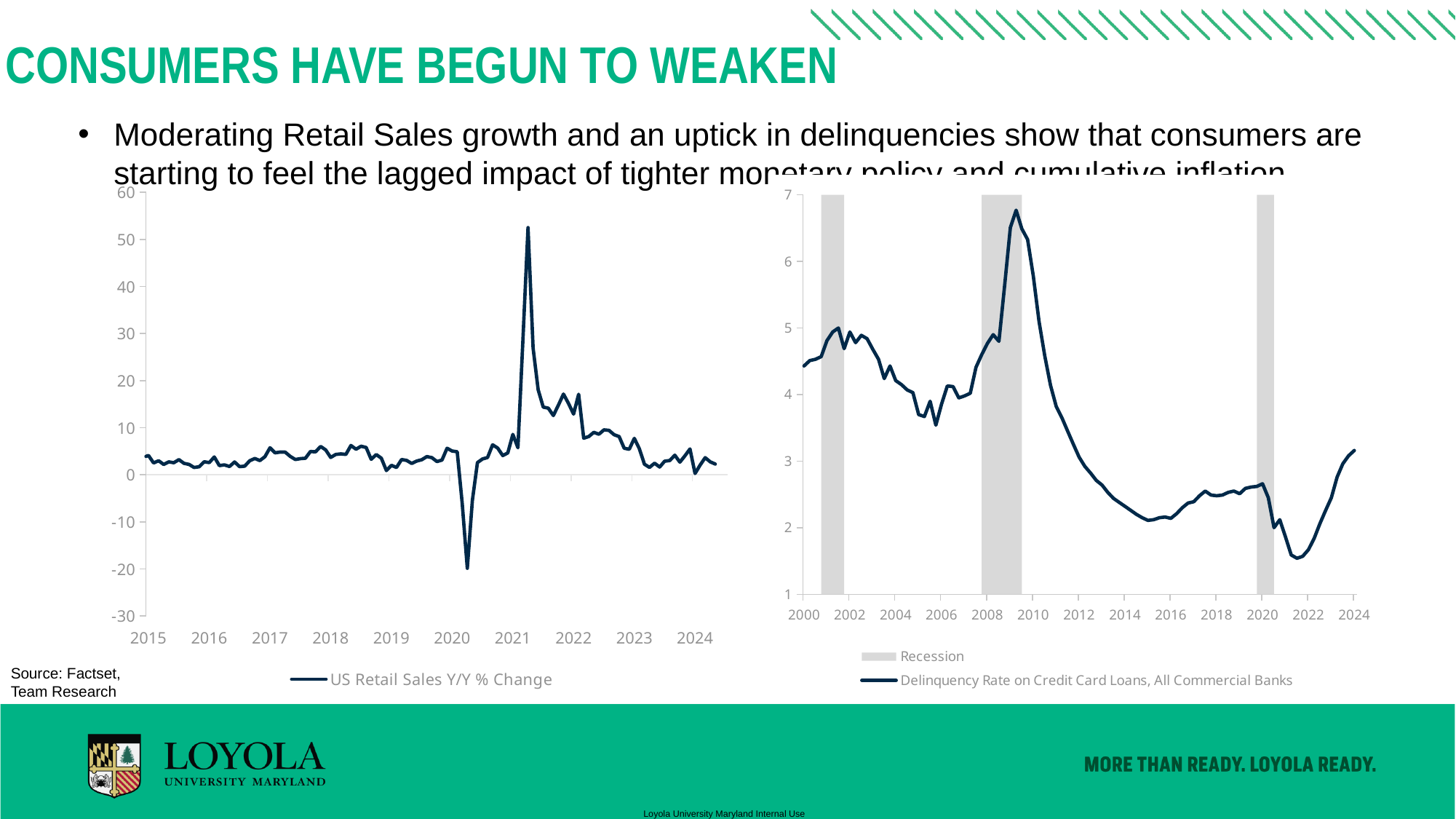
How many series does the legend of the left chart list? 1 What kind of chart is the right chart (Delinquency Rate on Credit Card Loans)? line chart In the right chart, does the delinquency rate rise or fall between 2010 and 2015? fall What does the grey shaded area in the right chart represent, according to the legend? Recession In the right chart, does the delinquency rate rise or fall between 2021 and 2024? rise In the right chart, is the delinquency rate at the start of 2000 greater or less than 4? greater How many entries does the legend of the right chart list? 2 What kind of chart is the left chart (US Retail Sales Y/Y % Change)? line chart In the left chart, is the lowest value of US Retail Sales Y/Y % Change in 2020 greater or less than -10? less In the right chart, is the peak delinquency rate around 2009 greater or less than 6? greater